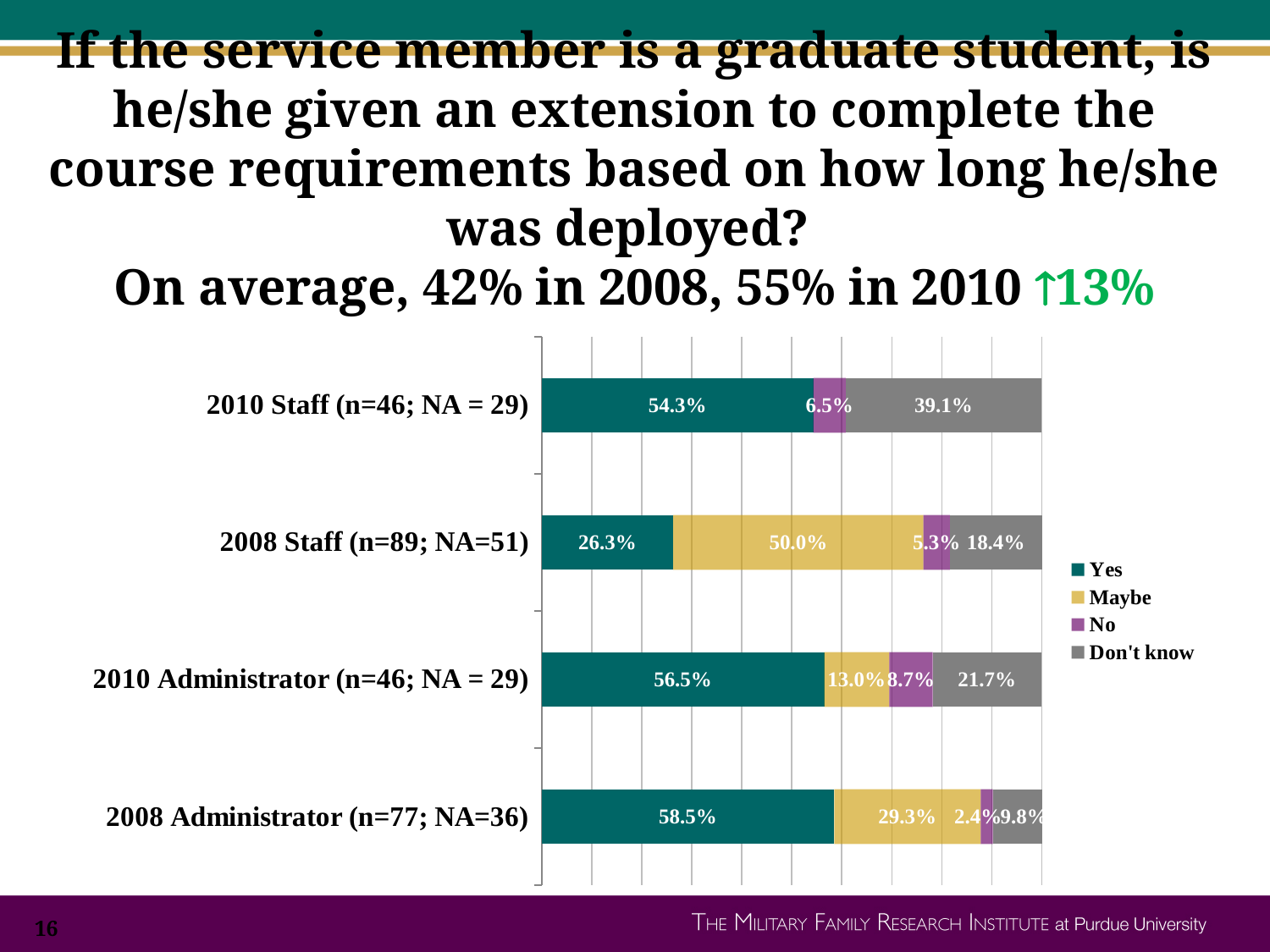
What is the "No" value for 2008 Administrator (n=77; NA=36)? 2.4% What kind of chart is shown on the slide? Stacked bar chart How many categories (bars) are shown in the chart? 4 What is the "Maybe" value for 2008 Staff (n=89; NA=51)? 50.0% Which category has the highest "Yes" value? 2008 Administrator (n=77; NA=36) Which legend entry is shown in yellow? Maybe How many series does the legend list? 4 What is the "Don't know" value for 2010 Administrator (n=46; NA = 29)? 21.7% Which is larger: the "Don't know" value for 2010 Staff or for 2008 Staff? 2010 Staff What is the difference between the "Yes" values for 2010 Staff and 2008 Staff? 28.0% Which category has the lowest "Yes" value? 2008 Staff (n=89; NA=51) What is the "Yes" value for 2010 Staff (n=46; NA = 29)? 54.3%